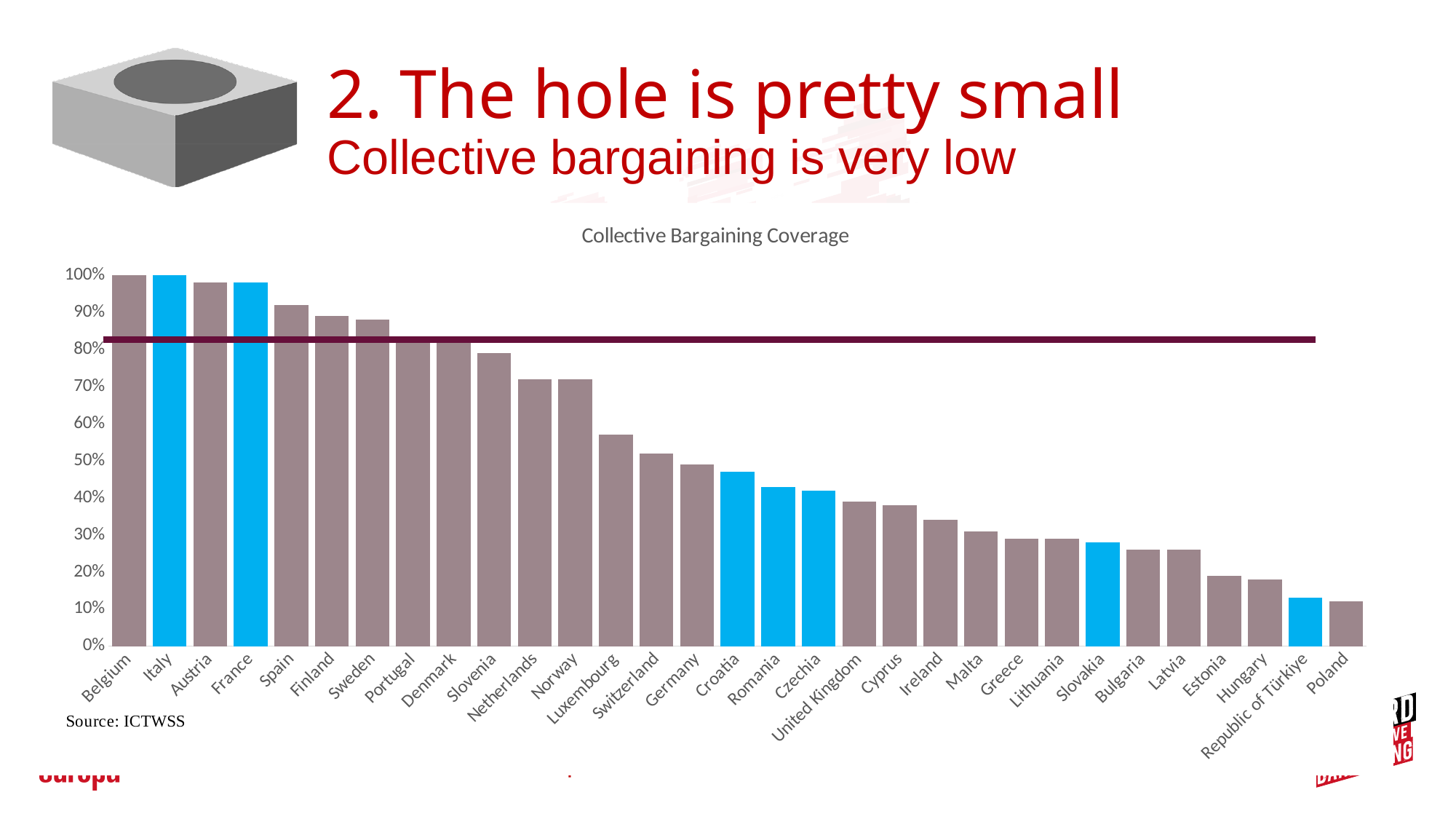
What source is cited below the chart? ICTWSS Which has the higher collective bargaining coverage, Spain or Germany? Spain Is the value for Poland greater or less than 20%? less How many countries are shown on the x axis of the chart? 31 Is the value for Croatia greater or less than 50%? less Is the value for Cyprus greater or less than 40%? less What kind of chart is shown on the slide? bar chart Which has the higher collective bargaining coverage, Croatia or Slovakia? Croatia What is the title of the chart? Collective Bargaining Coverage Do the values generally rise or fall moving from left to right along the x axis? fall